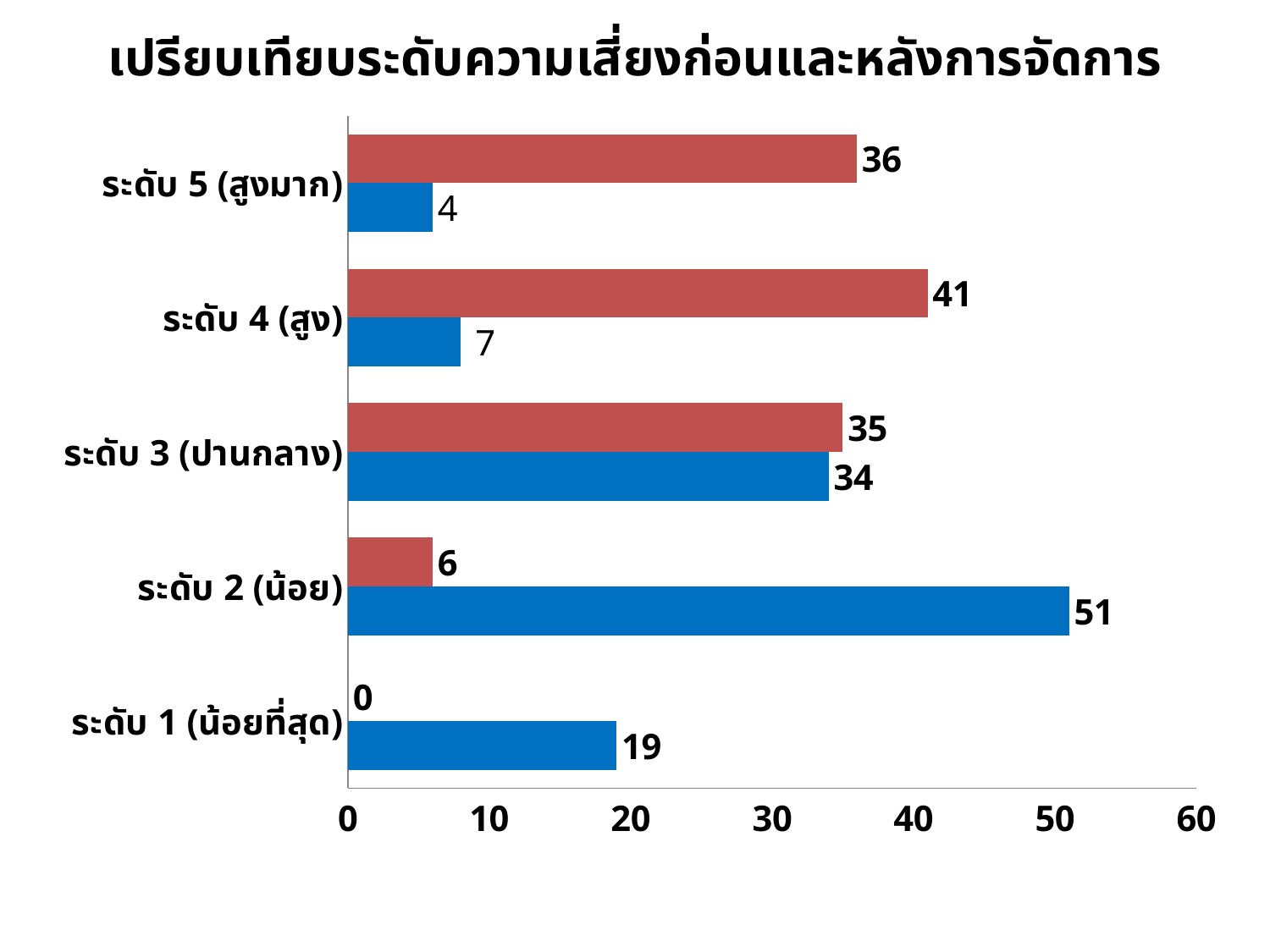
What type of chart is shown on the slide? bar chart Which category has the highest red bar? ระดับ 4 (สูง) What is the value of the blue bar for ระดับ 5 (สูงมาก)? 4 Which category has the lowest blue bar? ระดับ 5 (สูงมาก) For ระดับ 2 (น้อย), which bar is larger, the red or the blue? blue What is the difference between the red and blue bars for ระดับ 5 (สูงมาก)? 32 What is the title of the chart? เปรียบเทียบระดับความเสี่ยงก่อนและหลังการจัดการ What is the value of the blue bar for ระดับ 2 (น้อย)? 51 What is the difference between the blue bars for ระดับ 2 (น้อย) and ระดับ 1 (น้อยที่สุด)? 32 What is the value of the red bar for ระดับ 1 (น้อยที่สุด)? 0 How many categories are shown on the chart? 5 What is the value of the red bar for ระดับ 4 (สูง)? 41